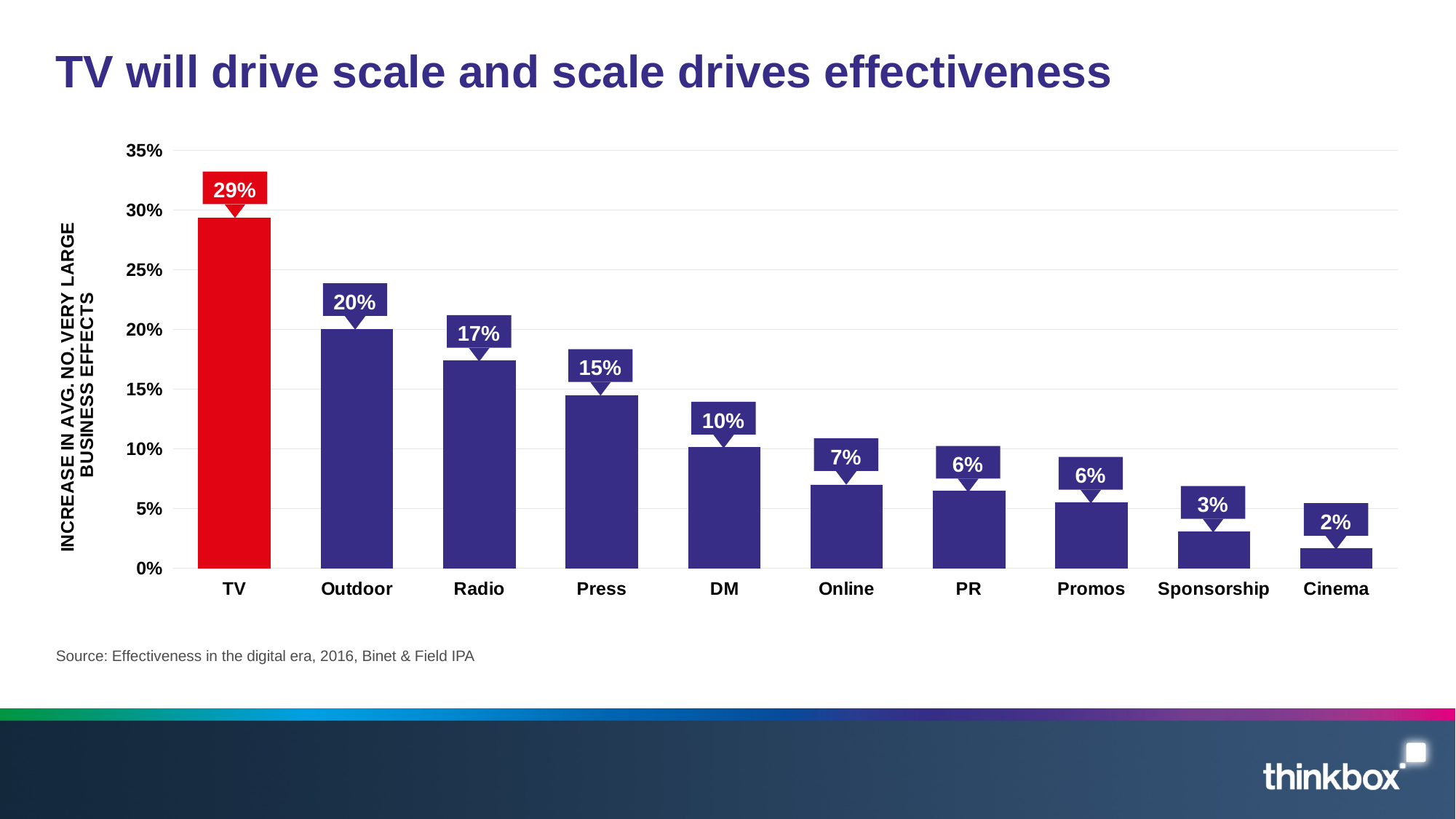
Which category has the highest value? TV Which is larger, the value for Outdoor or the value for Press? Outdoor What is the value for TV? 29% Which category has the lowest value? Cinema What is the value for Sponsorship? 3% How many categories are shown on the x axis? 10 Which bar is coloured red rather than purple? TV What is the value for Press? 15% What is the difference between the values for Radio and DM? 7% What is the difference between the values for TV and Outdoor? 9% What kind of chart is shown on the slide? Bar chart Do the values rise or fall from left to right along the x axis? Fall